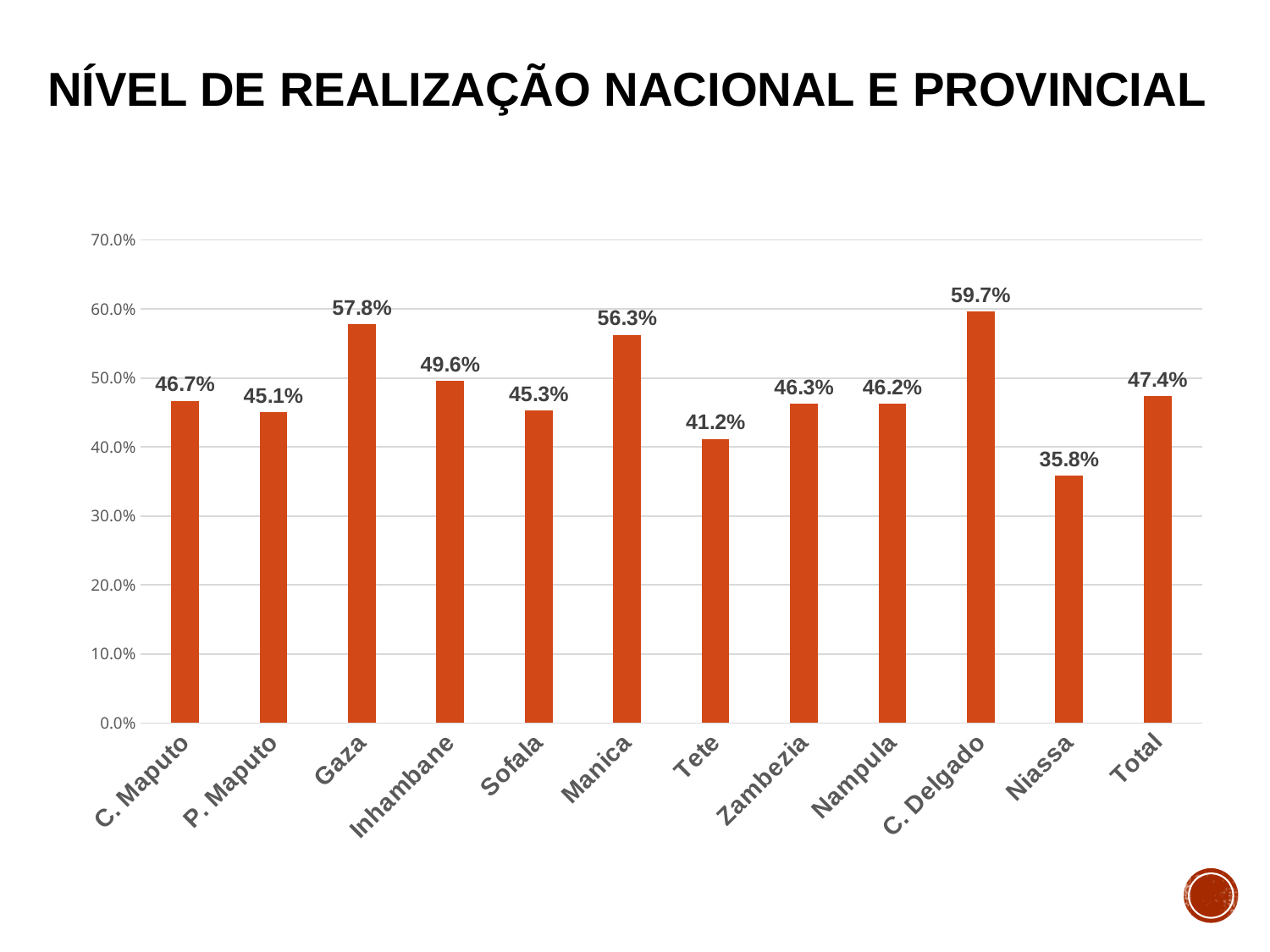
What is the value for Total? 47.4% What is the title of the slide? NÍVEL DE REALIZAÇÃO NACIONAL E PROVINCIAL What kind of chart is shown on the slide? bar chart What is the value for Gaza? 57.8% How many categories are shown on the x axis? 12 What is the difference between the values for Gaza and Manica? 1.5% Which category has the highest value? C. Delgado Is the value for Tete greater or less than 50.0%? less Which is larger, the value for Inhambane or the value for Sofala? Inhambane What is the value for Niassa? 35.8% Which category has the lowest value? Niassa What is the difference between the values for C. Delgado and Niassa? 23.9%